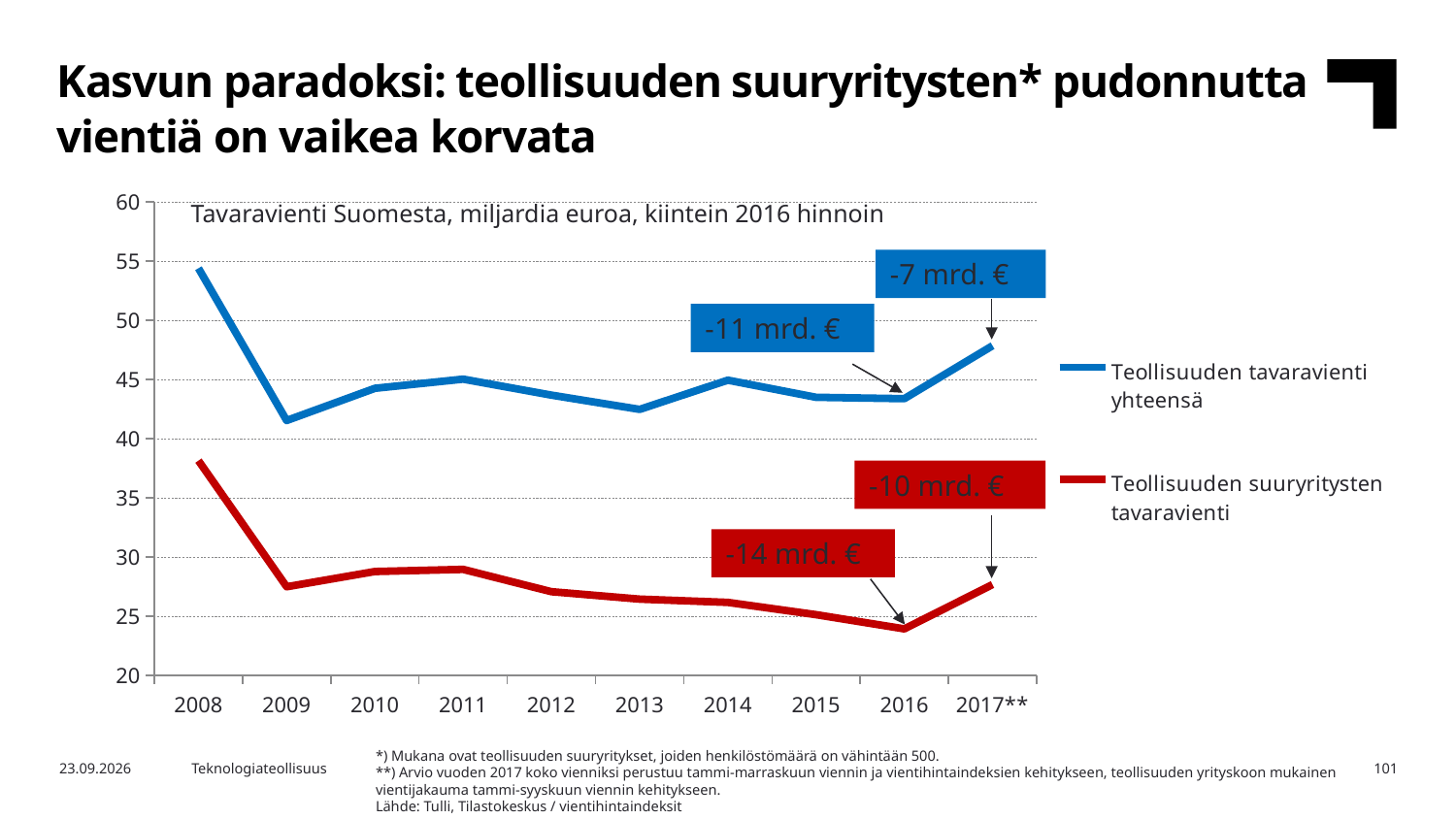
In which year is the value for Teollisuuden tavaravienti yhteensä highest? 2008 Is the value for Teollisuuden tavaravienti yhteensä in 2008 greater or less than 50? greater In which year is the value for Teollisuuden suuryritysten tavaravienti lowest? 2016 What colour is the line for Teollisuuden suuryritysten tavaravienti? red Which is larger for Teollisuuden tavaravienti yhteensä: the value in 2008 or the value in 2017**? 2008 Is the value for Teollisuuden suuryritysten tavaravienti in 2016 greater or less than 30? less In which year is the value for Teollisuuden suuryritysten tavaravienti highest? 2008 What kind of chart is shown on the slide? line chart How many series does the legend list? 2 What is the title printed inside the chart area? Tavaravienti Suomesta, miljardia euroa, kiintein 2016 hinnoin How many years are plotted along the x axis? 10 Does the value for Teollisuuden suuryritysten tavaravienti rise or fall from 2011 to 2016? fall